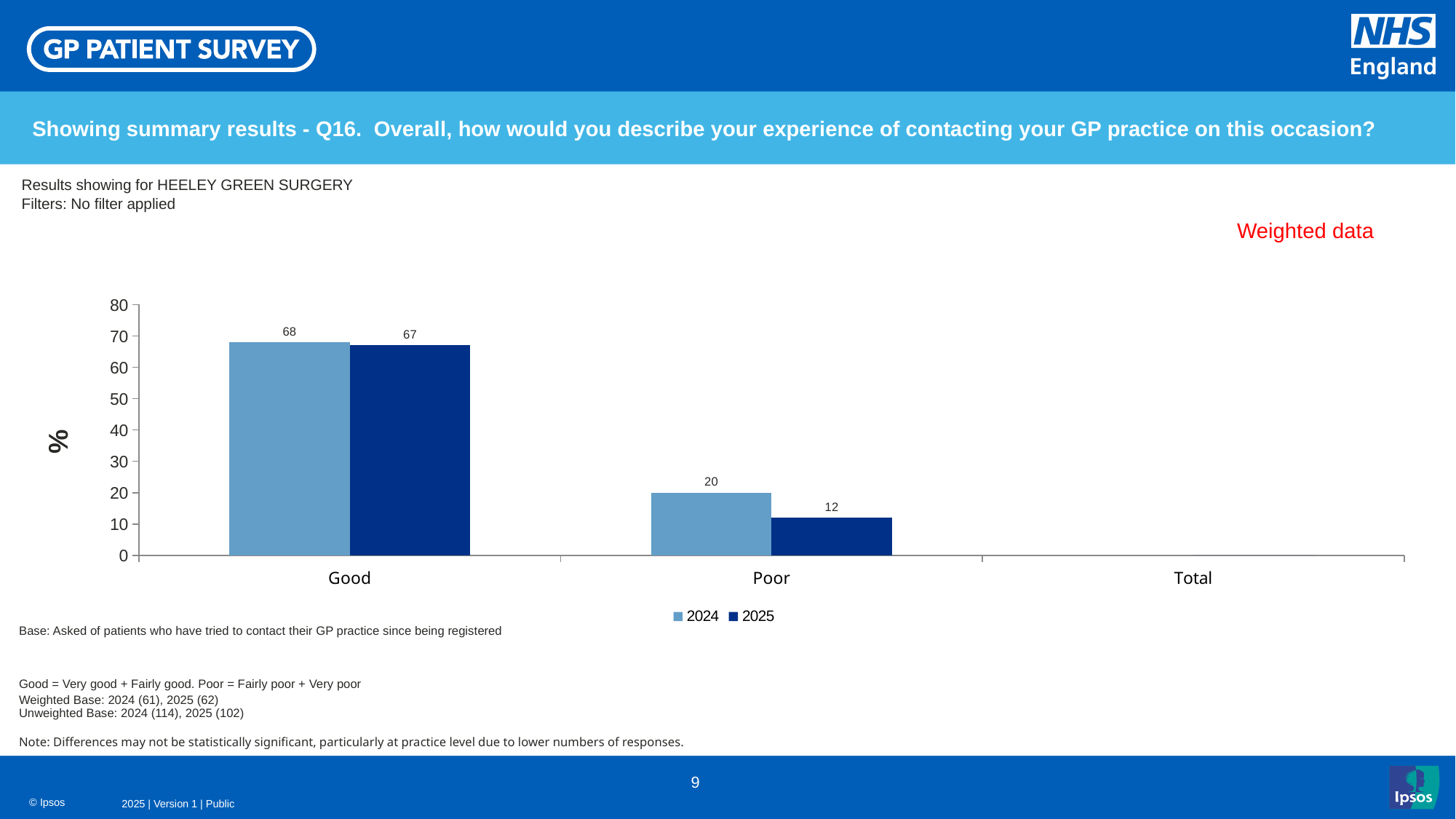
How many series does the legend list? 2 What is the value for Poor in 2024? 20 What is the value for Poor in 2025? 12 Which is larger, the 2024 value for Poor or the 2025 value for Poor? 2024 Which category has the highest value for 2025? Good Which category has the lowest value for 2024? Poor What is the difference between the 2024 and 2025 values for Poor? 8 What kind of chart is shown on the slide? Bar chart What is the value for Good in 2025? 67 What is the difference between the Good and Poor values for 2024? 48 What label is shown on the y axis of the chart? % What is the value for Good in 2024? 68